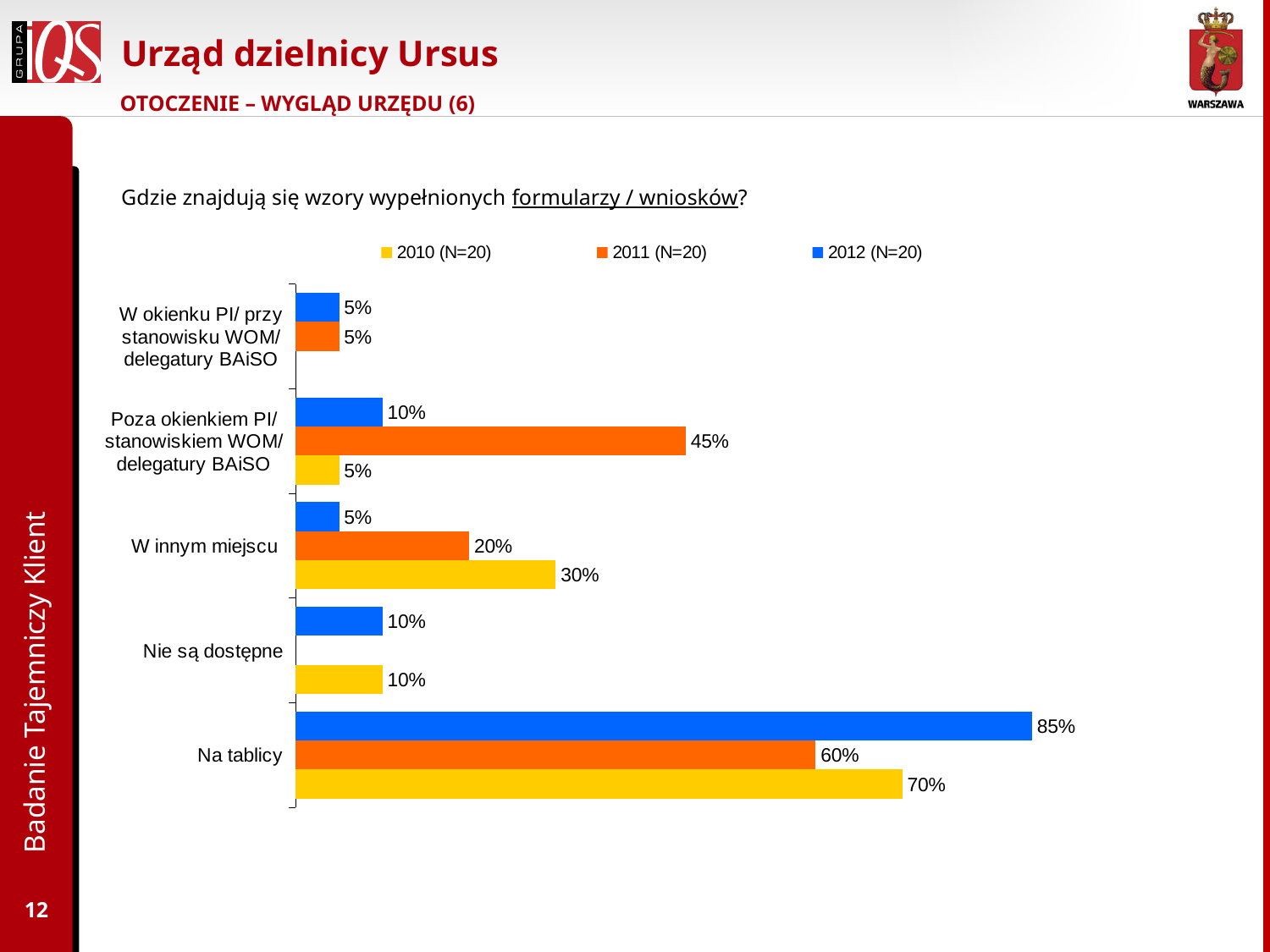
Which category has the lowest value in the 2010 (N=20) series? Poza okienkiem PI/ stanowiskiem WOM/ delegatury BAiSO What is the value for 'Na tablicy' in the 2012 (N=20) series? 85% How many categories are shown on the chart? 5 Which category has the highest value in the 2012 (N=20) series? Na tablicy What type of chart is shown on the slide? bar chart For 'W innym miejscu', which is larger: the 2011 (N=20) value or the 2010 (N=20) value? 2010 (N=20) What is the value for 'W innym miejscu' in the 2010 (N=20) series? 30% Which colour represents the 2011 (N=20) series in the legend? orange What is the value for 'Poza okienkiem PI/ stanowiskiem WOM/ delegatury BAiSO' in the 2011 (N=20) series? 45% What is the difference between the 2012 (N=20) and 2011 (N=20) values for 'Na tablicy'? 25% What is the value for 'Nie są dostępne' in the 2010 (N=20) series? 10% How many series does the legend list? 3